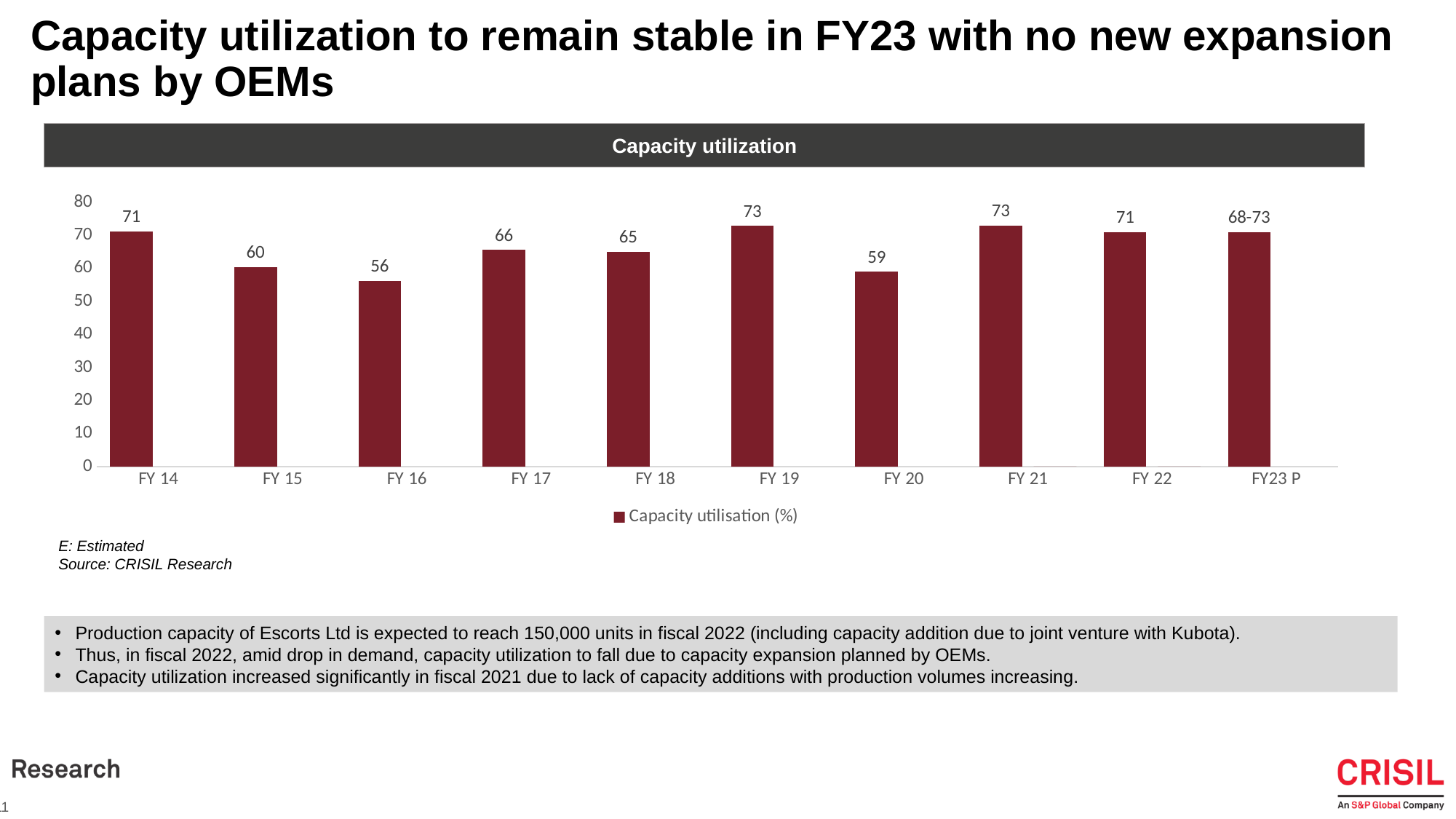
Which fiscal year has the lowest capacity utilisation in the chart? FY 16 What is the highest capacity utilisation value labelled in the chart? 73 How many series does the chart legend list? 1 What value is labelled on the bar for FY23 P? 68-73 What is the difference between the capacity utilisation values for FY 21 and FY 20? 14 What type of chart is used to show capacity utilization? Bar chart What is the legend entry shown below the chart? Capacity utilisation (%) How many fiscal years are shown on the x axis of the chart? 10 Is the value for FY 15 greater or less than 50? greater Which has a higher capacity utilisation value, FY 17 or FY 18? FY 17 What is the capacity utilisation value shown for FY 16? 56 What is the capacity utilisation value shown for FY 19? 73